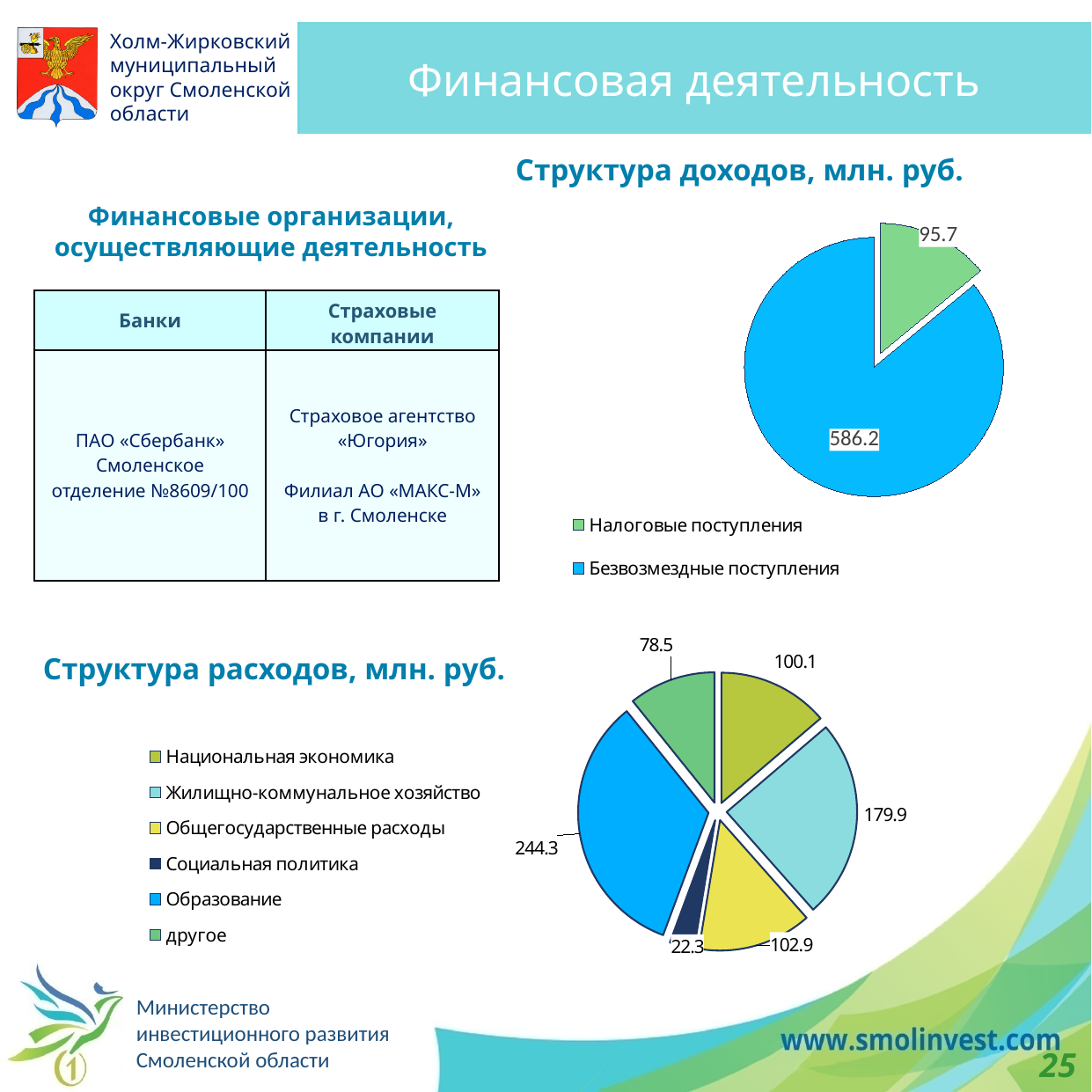
In the chart titled «Структура расходов, млн. руб.», what is the difference between «Образование» and «Жилищно-коммунальное хозяйство»? 64.4 In the chart titled «Структура расходов, млн. руб.», which category has the largest value? Образование In the chart titled «Структура расходов, млн. руб.», how many categories are shown? 6 In the chart titled «Структура расходов, млн. руб.», which is larger: «Жилищно-коммунальное хозяйство» or «другое»? Жилищно-коммунальное хозяйство In the chart titled «Структура доходов, млн. руб.», what is the difference between «Безвозмездные поступления» and «Налоговые поступления»? 490.5 In the chart titled «Структура доходов, млн. руб.», what is the value for «Безвозмездные поступления»? 586.2 In the chart titled «Структура расходов, млн. руб.», which category has the smallest value? Социальная политика What kind of chart is the one titled «Структура расходов, млн. руб.»? pie chart In the chart titled «Структура доходов, млн. руб.», how many entries does the legend list? 2 In the chart titled «Структура доходов, млн. руб.», what is the value for «Налоговые поступления»? 95.7 In the chart titled «Структура расходов, млн. руб.», what is the value for «Социальная политика»? 22.3 In the chart titled «Структура расходов, млн. руб.», what is the value for «Образование»? 244.3